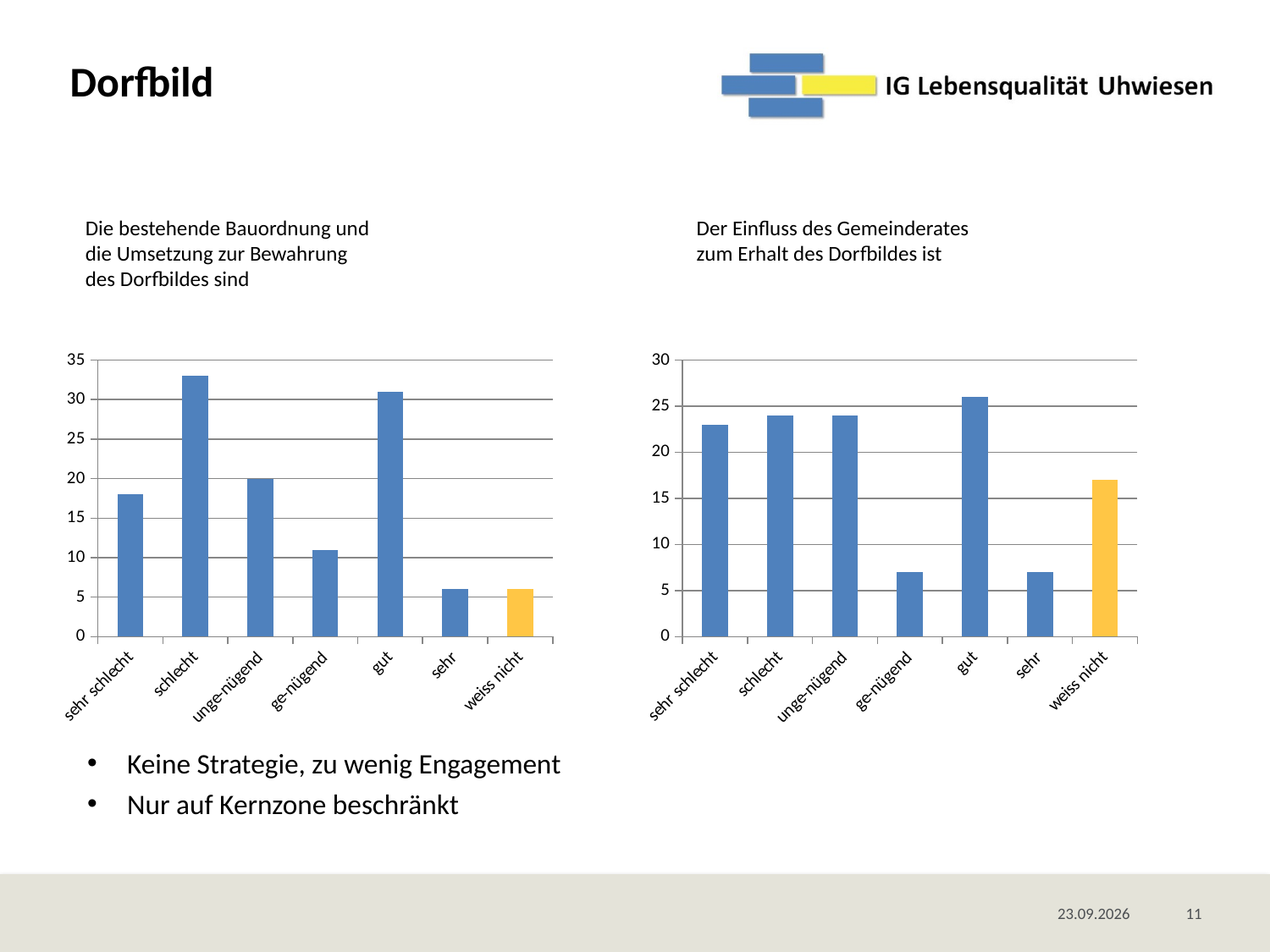
On the left chart (Die bestehende Bauordnung...), how many categories are shown on the x axis? 7 On the left chart (Die bestehende Bauordnung...), is the value for 'schlecht' greater or less than 30? greater On the left chart (Die bestehende Bauordnung...), which is larger, the value for 'gut' or the value for 'sehr'? gut On the left chart (Die bestehende Bauordnung...), is the value for 'ge-nügend' greater or less than 15? less On the right chart (Der Einfluss des Gemeinderates...), is the value for 'ge-nügend' greater or less than 10? less On the right chart (Der Einfluss des Gemeinderates...), which is larger, the value for 'sehr schlecht' or the value for 'sehr'? sehr schlecht What type of chart is the right chart (Der Einfluss des Gemeinderates...)? bar chart On the right chart (Der Einfluss des Gemeinderates...), which category has the highest value? gut On the left chart (Die bestehende Bauordnung...), which category's bar is coloured differently (yellow) from the others? weiss nicht